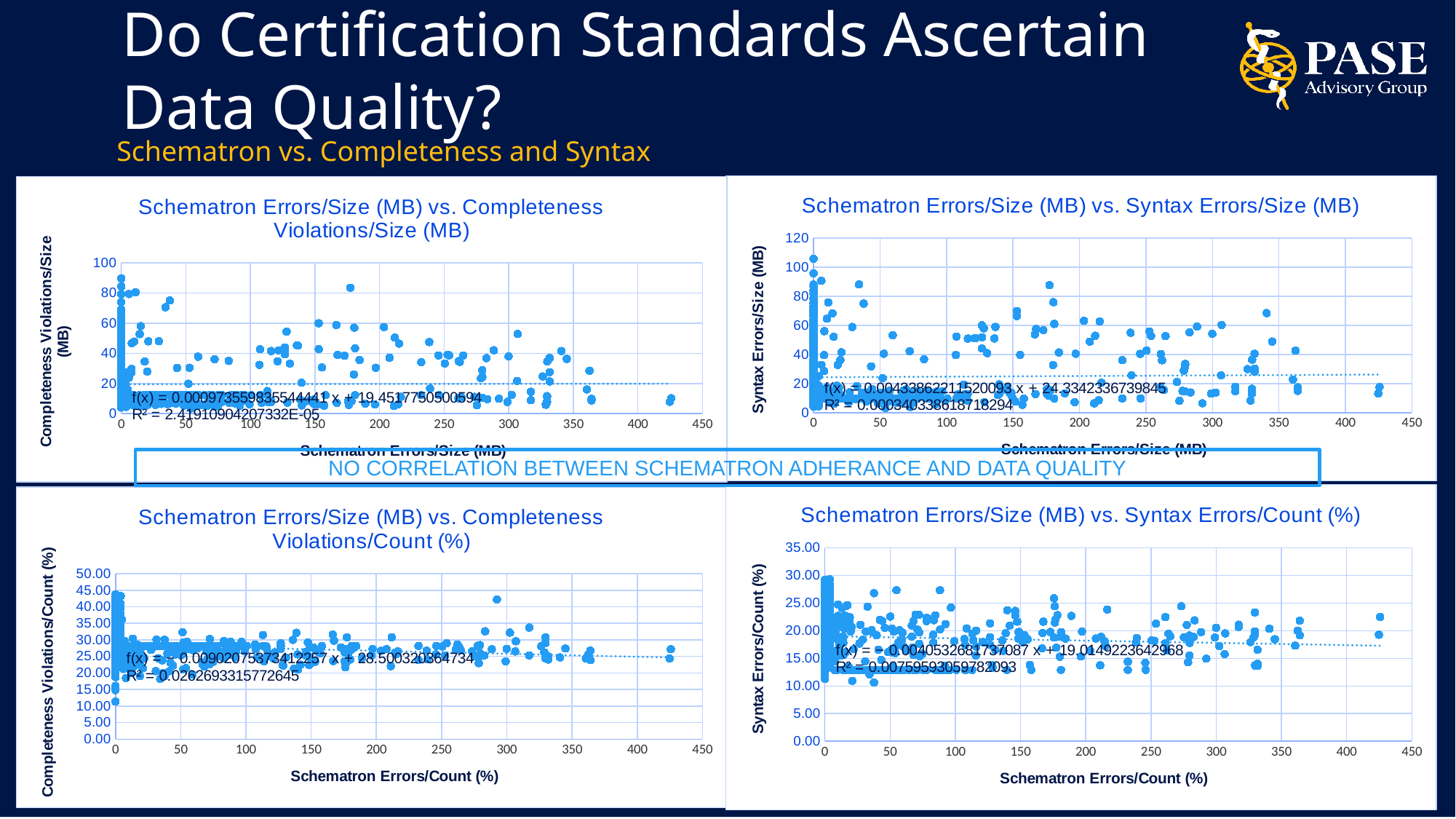
In the top-right chart "Schematron Errors/Size (MB) vs. Syntax Errors/Size (MB)", is the value of the point at x ≈ 425 greater or less than 40? less In the bottom-left chart "Schematron Errors/Size (MB) vs. Completeness Violations/Count (%)", is the value of the highest point near x ≈ 290 greater or less than 35.00? greater In the bottom-right chart "Schematron Errors/Size (MB) vs. Syntax Errors/Count (%)", what is the label of the x axis? Schematron Errors/Count (%) In the bottom-right chart "Schematron Errors/Size (MB) vs. Syntax Errors/Count (%)", what R² value is printed for the trendline? 0.00759593059782093 In the bottom-left chart "Schematron Errors/Size (MB) vs. Completeness Violations/Count (%)", does the fitted trendline rise or fall as x increases? fall In the top-right chart "Schematron Errors/Size (MB) vs. Syntax Errors/Size (MB)", what is the highest value shown on the y axis? 120 How many charts are shown on the slide? 4 In the top-right chart "Schematron Errors/Size (MB) vs. Syntax Errors/Size (MB)", what R² value is printed for the trendline? 0.000340338618718294 In the top-left chart "Schematron Errors/Size (MB) vs. Completeness Violations/Size (MB)", is the value of the point at x ≈ 425 greater or less than 20? less In the top-right chart "Schematron Errors/Size (MB) vs. Syntax Errors/Size (MB)", does the fitted trendline rise or fall as x increases? rise What kind of chart is the top-left chart titled "Schematron Errors/Size (MB) vs. Completeness Violations/Size (MB)"? Scatter chart